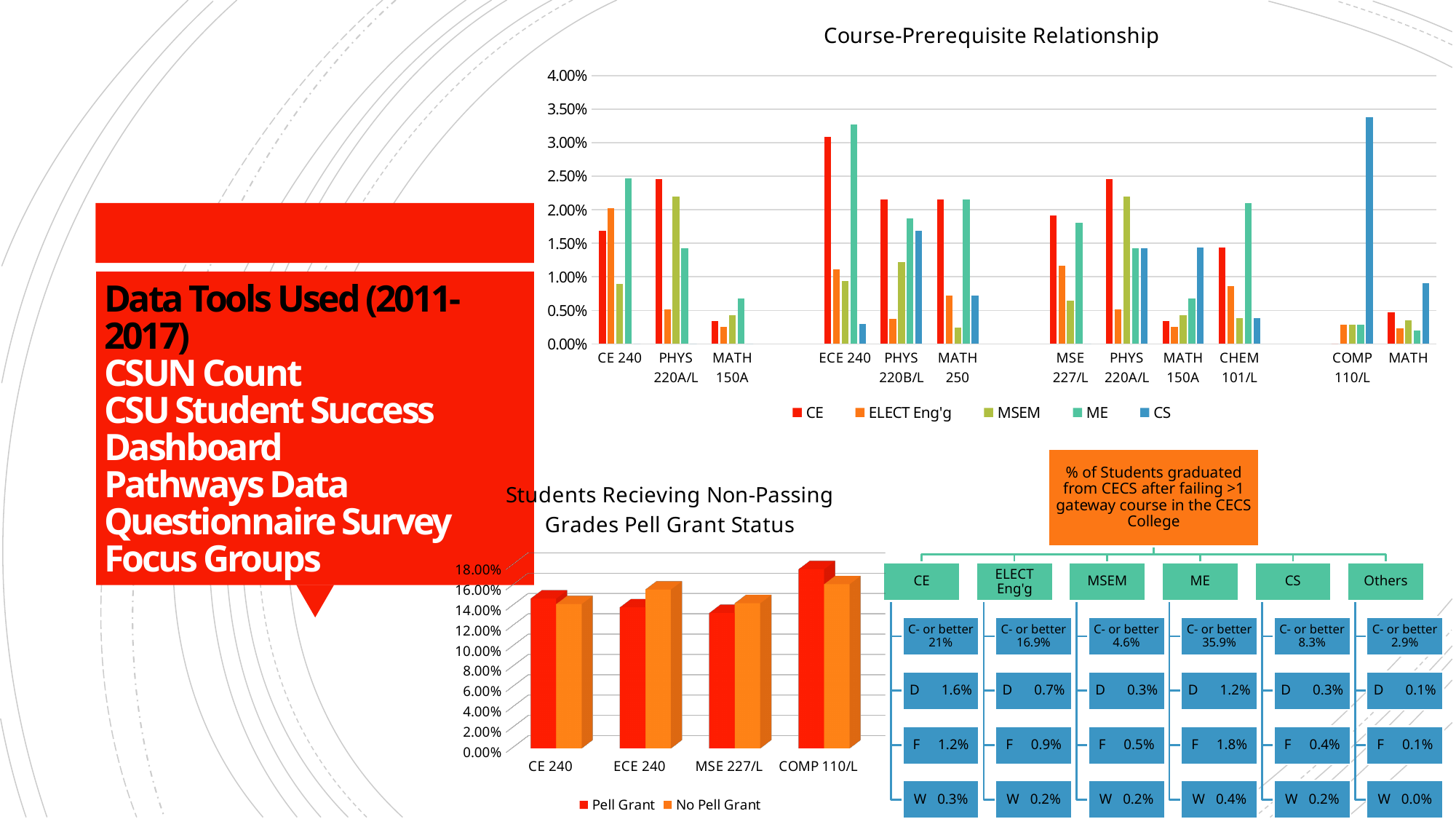
What type of chart is the "Students Recieving Non-Passing Grades Pell Grant Status" chart? bar chart In the "Course-Prerequisite Relationship" chart, is the ME value for ECE 240 greater or less than 3.00%? greater In the "Course-Prerequisite Relationship" chart, is the CS value for COMP 110/L greater or less than 3.00%? greater What type of chart is the "Course-Prerequisite Relationship" chart? bar chart In the "Course-Prerequisite Relationship" chart, which series has the highest value for COMP 110/L? CS How many course categories are shown on the x axis of the "Students Recieving Non-Passing Grades Pell Grant Status" chart? 4 In the "Course-Prerequisite Relationship" chart, for CE 240, which is larger: the CE value or the ME value? ME In the "Course-Prerequisite Relationship" chart, which series has the lowest value for ECE 240? CS How many series does the legend of the "Course-Prerequisite Relationship" chart list? 5 In the "Students Recieving Non-Passing Grades Pell Grant Status" chart, for ECE 240, which is larger: Pell Grant or No Pell Grant? No Pell Grant In the "Course-Prerequisite Relationship" chart, is the CE value for CE 240 greater or less than 1.50%? greater In the "Students Recieving Non-Passing Grades Pell Grant Status" chart, which course has the highest Pell Grant value? COMP 110/L